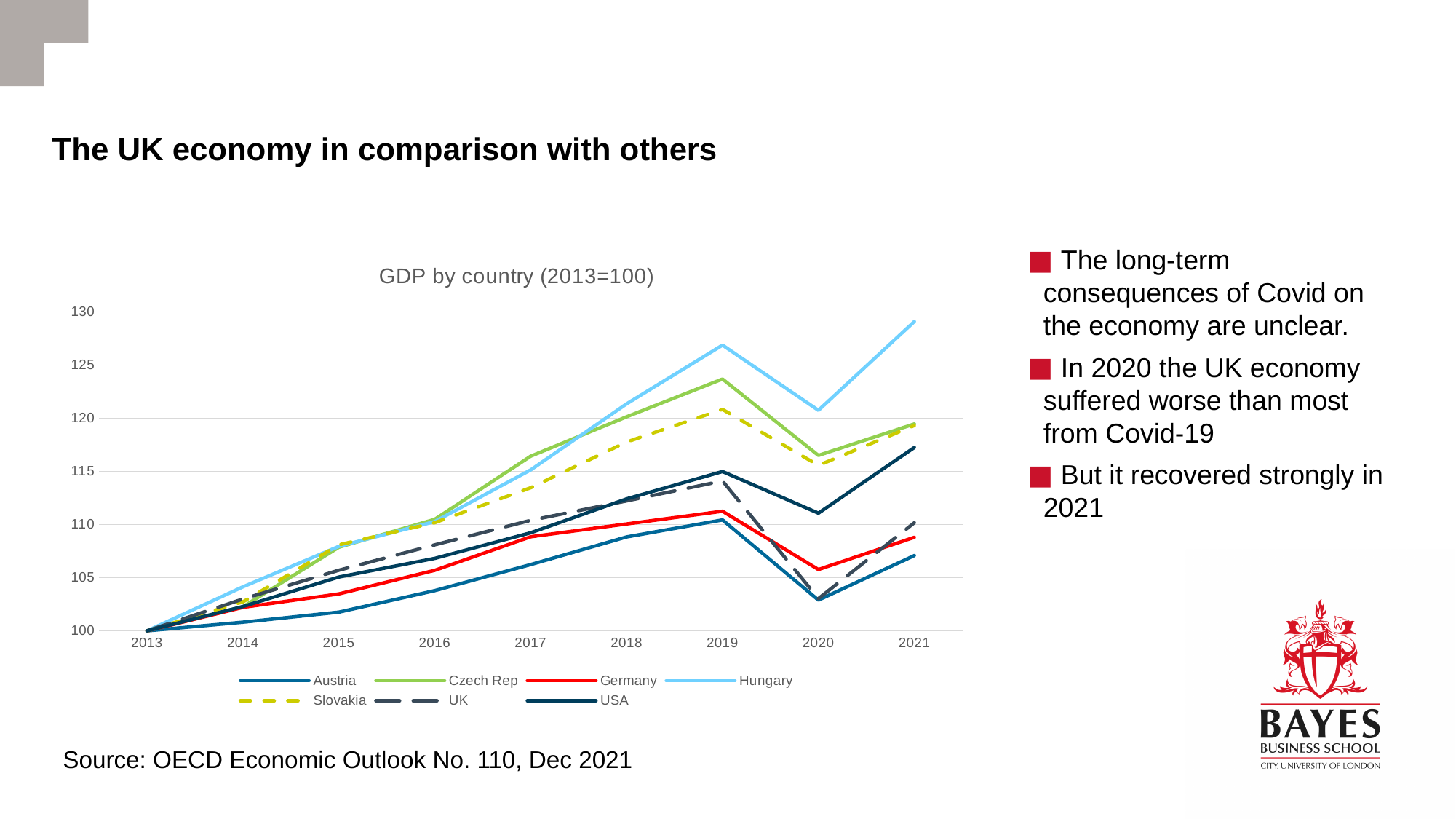
What kind of chart is shown on the slide? line chart Is the value for Germany in 2020 greater or less than 110? less How many years are shown along the x axis? 9 Does the value for Hungary rise or fall from 2013 to 2019? rise In 2021, which is larger: the value for the USA or the value for the UK? USA What is the value for the UK in 2013? 100 Is the value for the UK in 2020 greater or less than 105? less What is the title of the chart? GDP by country (2013=100) Is the value for Hungary in 2021 greater or less than 125? greater Which country has the lowest value in 2021? Austria How many series does the legend list? 7 Which country has the highest value in 2021? Hungary